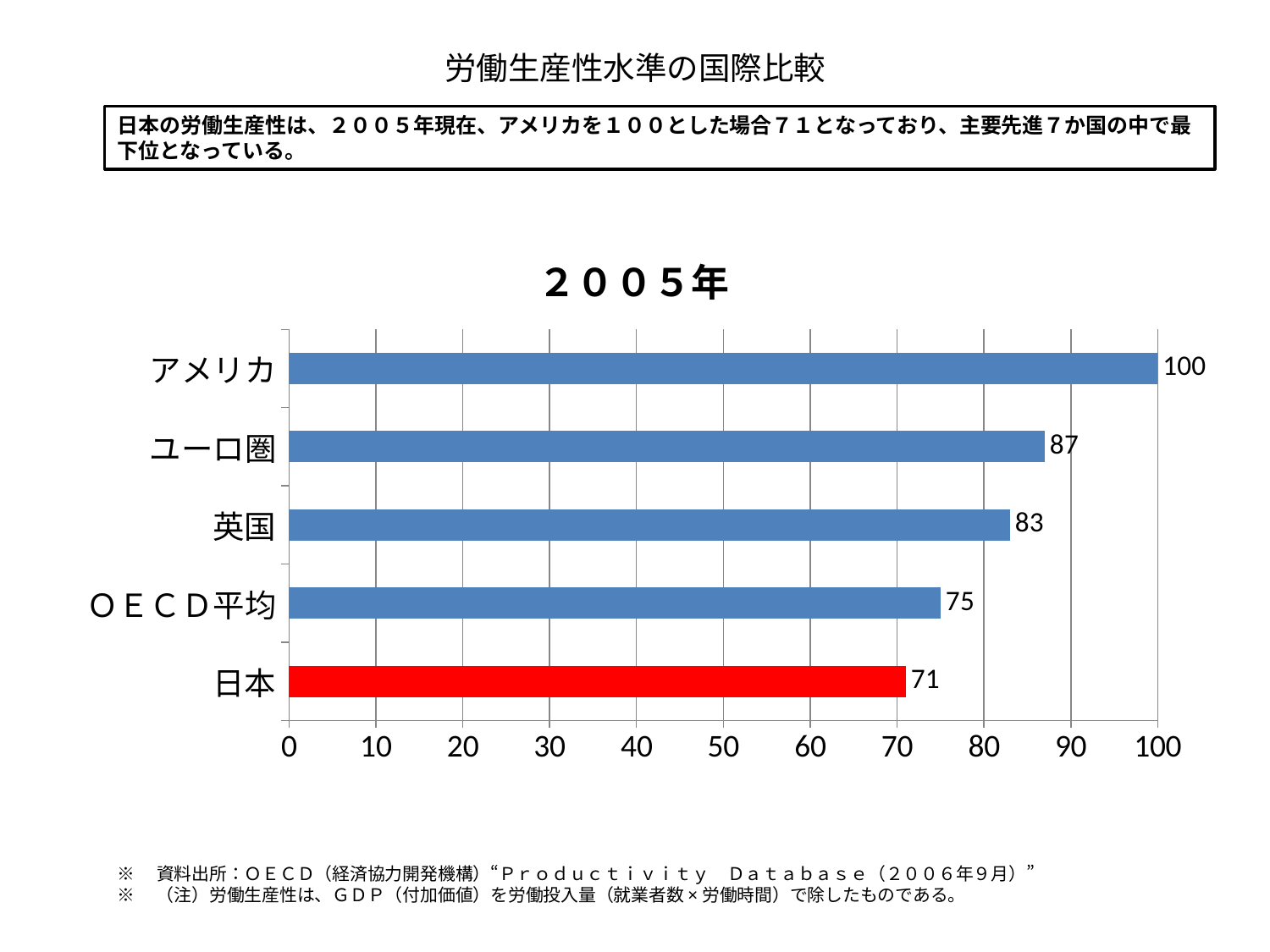
What kind of chart is shown on the slide? bar chart What is the difference between the values for ユーロ圏 and 英国? 4 Which category has the lowest value in the chart? 日本 What is the title of the chart? ２００５年 Which is larger, the value for 英国 or the value for ＯＥＣＤ平均? 英国 What is the value for ＯＥＣＤ平均 in the chart? 75 Is the value for 英国 greater or less than 80? greater Which category has the highest value in the chart? アメリカ What is the value for 日本 in the chart? 71 How many categories are shown in the chart? 5 What is the value for ユーロ圏 in the chart? 87 What is the difference between the values for アメリカ and 日本? 29